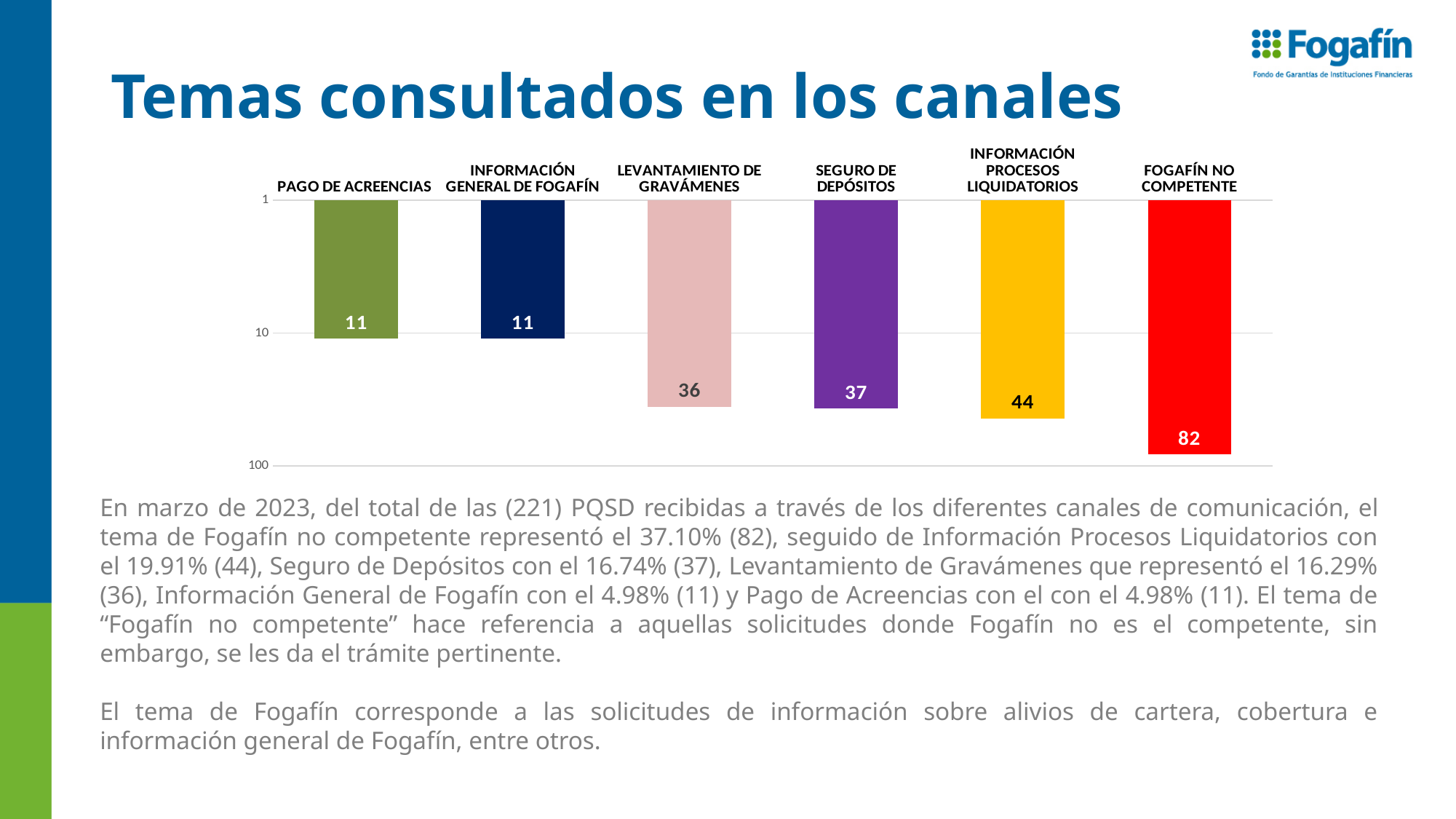
What is the value for SEGURO DE DEPÓSITOS? 37 What is the value for INFORMACIÓN PROCESOS LIQUIDATORIOS? 44 Which is larger, the value for INFORMACIÓN PROCESOS LIQUIDATORIOS or the value for SEGURO DE DEPÓSITOS? INFORMACIÓN PROCESOS LIQUIDATORIOS What is the value for LEVANTAMIENTO DE GRAVÁMENES? 36 What kind of chart is shown on the slide? Bar chart What is the value for PAGO DE ACREENCIAS? 11 What is the value for FOGAFÍN NO COMPETENTE? 82 What is the difference between the values for FOGAFÍN NO COMPETENTE and INFORMACIÓN PROCESOS LIQUIDATORIOS? 38 What is the difference between the values for LEVANTAMIENTO DE GRAVÁMENES and INFORMACIÓN GENERAL DE FOGAFÍN? 25 What colour is the bar for FOGAFÍN NO COMPETENTE? Red How many categories are shown in the chart? 6 Which category has the highest value? FOGAFÍN NO COMPETENTE